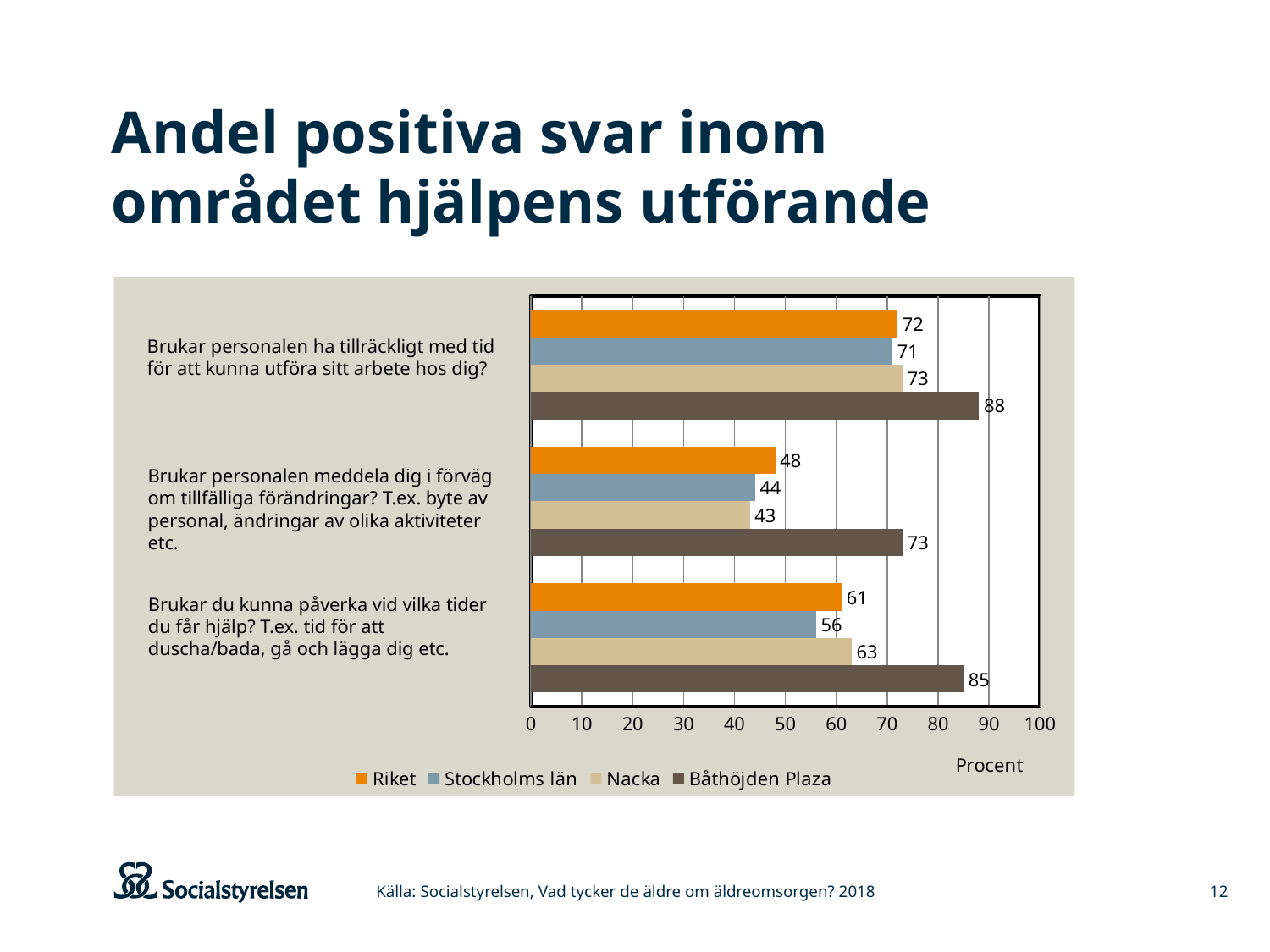
What kind of chart is shown on the slide? Bar chart Which is larger on the question "Brukar du kunna påverka vid vilka tider du får hjälp?": Riket or Nacka? Nacka What is the value for Stockholms län on the question "Brukar du kunna påverka vid vilka tider du får hjälp?"? 56 What is the value for Nacka on the question "Brukar personalen meddela dig i förväg om tillfälliga förändringar?"? 43 How many questions (categories) are shown on the chart? 3 How many series does the legend list? 4 What unit is shown on the horizontal axis of the chart? Procent Which series has the lowest value on the question "Brukar personalen meddela dig i förväg om tillfälliga förändringar?"? Nacka Which series has the highest value on the question "Brukar du kunna påverka vid vilka tider du får hjälp?"? Båthöjden Plaza What is the value for Båthöjden Plaza on the question "Brukar personalen ha tillräckligt med tid för att kunna utföra sitt arbete hos dig?"? 88 Is the value for Båthöjden Plaza on the question "Brukar personalen ha tillräckligt med tid för att kunna utföra sitt arbete hos dig?" greater or less than 80? greater What is the difference between Båthöjden Plaza and Riket on the question "Brukar personalen meddela dig i förväg om tillfälliga förändringar?"? 25